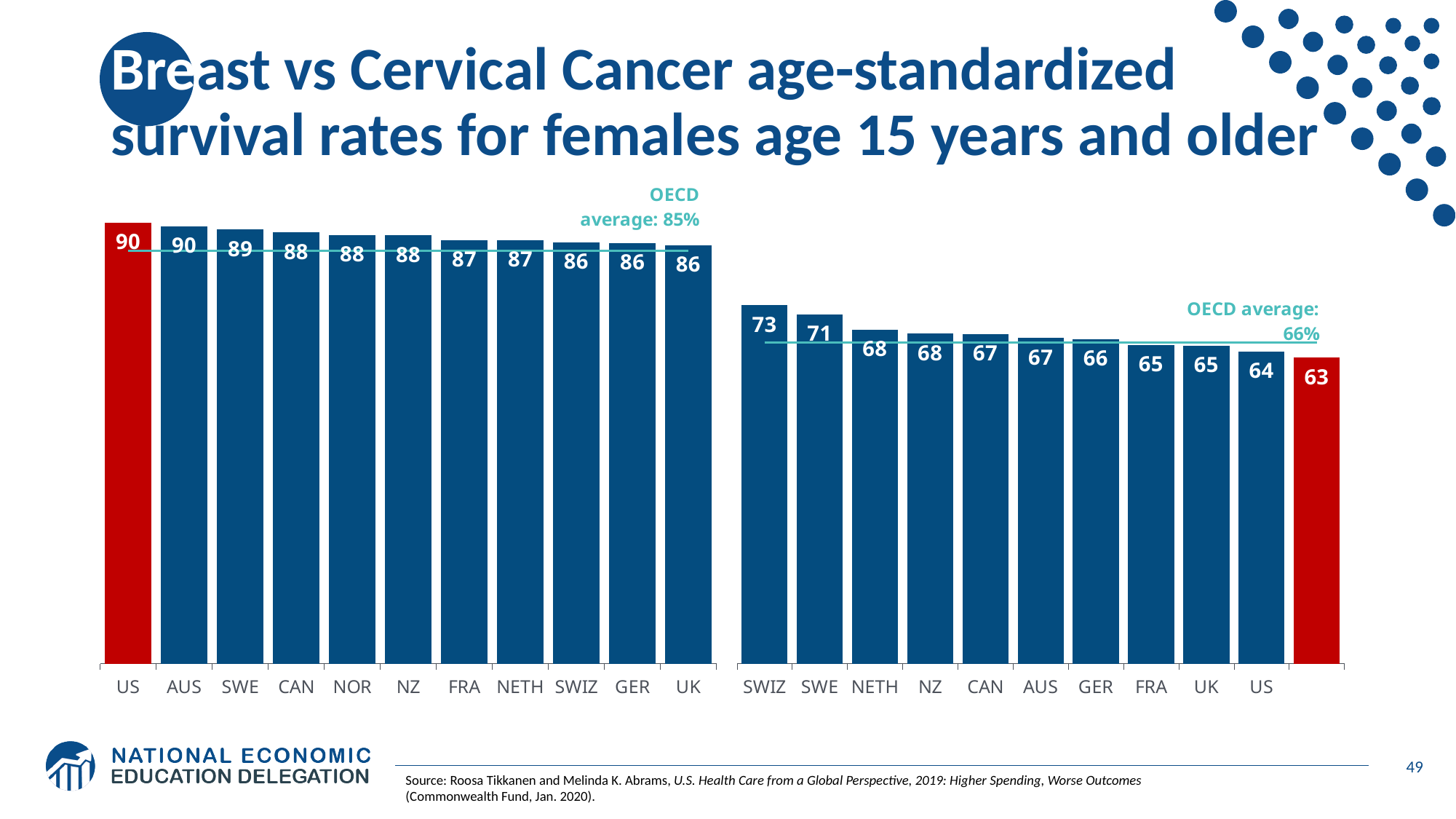
What OECD average is shown for the left group of bars? 85% In the left group of bars, what is the value for UK? 86 In the right group of bars, what is the value for US? 64 In the left group of bars, what is the difference between the value for US and the value for UK? 4 In the right group of bars, what is the value for SWIZ? 73 In the right group of bars, which labelled country has the highest value? SWIZ How many labelled countries are in the left group of bars? 11 In the right group of bars, what is the difference between the value for SWIZ and the value for SWE? 2 What kind of chart is shown on the slide? bar chart In the right group of bars, which is larger, the value for NETH or the value for FRA? NETH In the left group of bars, what is the value for SWE? 89 What OECD average is shown for the right group of bars? 66%